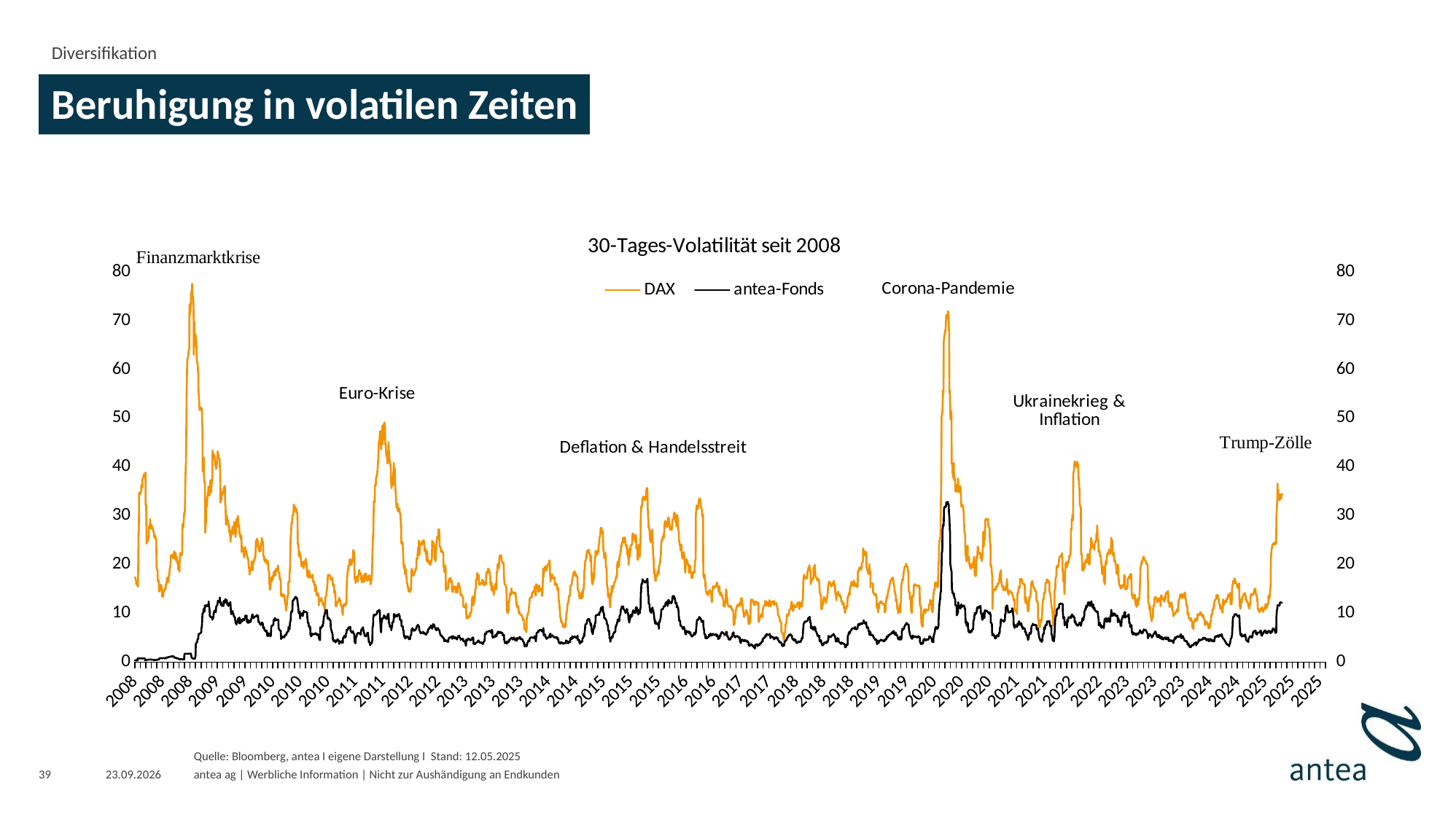
At which annotated event does the DAX series reach its highest value in the chart? Finanzmarktkrise Is the peak value of the DAX series during the Euro-Krise greater or less than 40? greater What kind of chart is shown on the slide? line chart How many series does the legend of the chart list? 2 At the Corona-Pandemie peak, which series reaches the higher value, DAX or antea-Fonds? DAX Is the peak value of the DAX series during the Finanzmarktkrise greater or less than 70? greater Which series stays lower than the other across almost the entire period shown? antea-Fonds Which series is drawn in orange in the chart? DAX Is the peak value of the DAX series during the Euro-Krise greater or less than 60? less What is the title of the chart? 30-Tages-Volatilität seit 2008